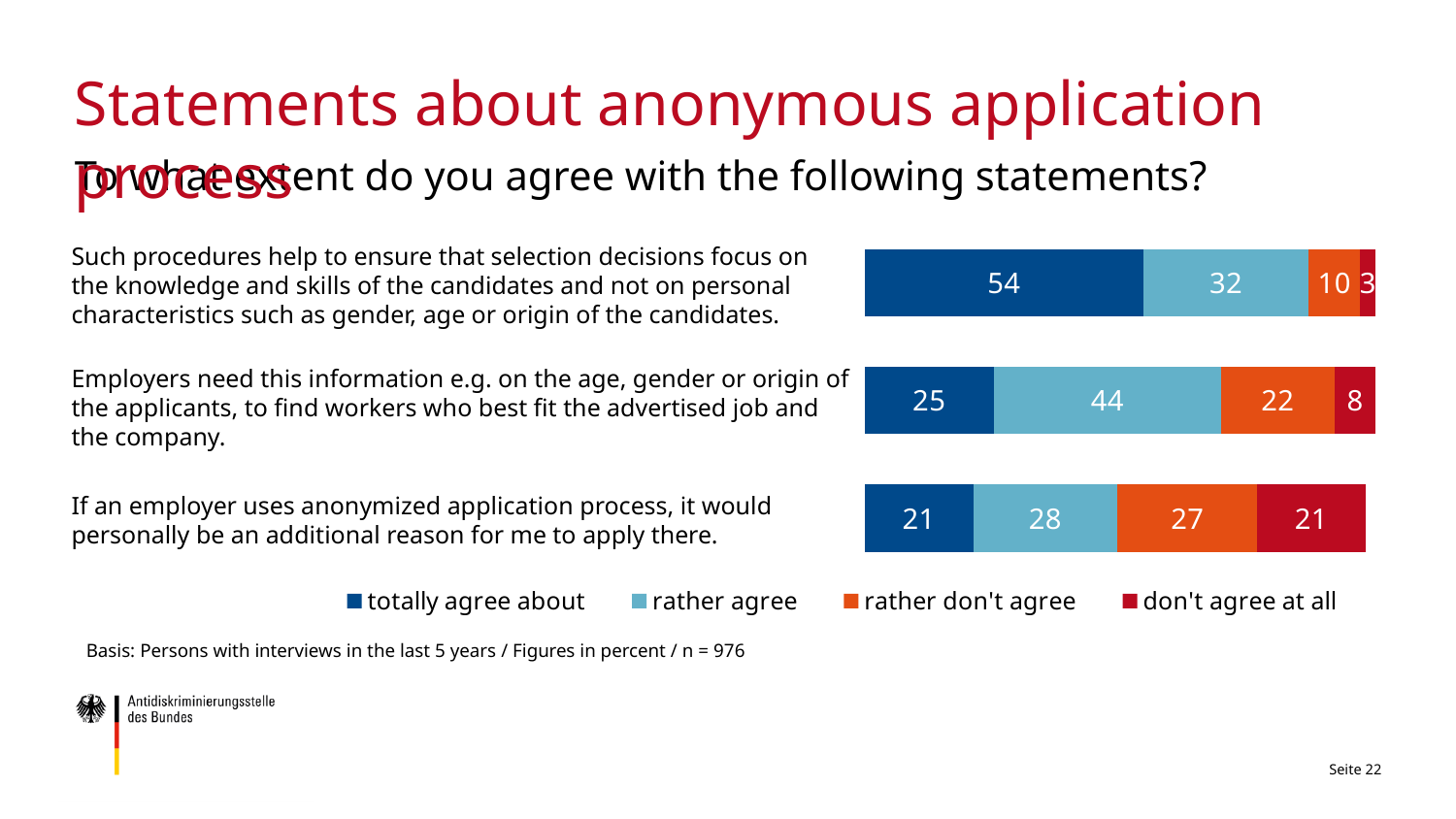
What is the difference between the 'totally agree' share for the statement that such procedures help focus on knowledge and skills and the 'totally agree' share for the statement that employers need this information? 29 What kind of chart is shown on the slide? Stacked bar chart How many series does the legend list? 4 What percentage of respondents totally agree that such procedures help to ensure that selection decisions focus on the knowledge and skills of the candidates? 54 Which statement has the highest share of respondents who totally agree? Such procedures help to ensure that selection decisions focus on the knowledge and skills of the candidates What percentage of respondents rather don't agree that employers need this information on the age, gender or origin of the applicants? 22 What percentage of respondents rather agree that employers need this information on the age, gender or origin of the applicants? 44 For the statement that an anonymized application process would be an additional reason to apply, which is larger: the 'rather agree' share or the 'rather don't agree' share? rather agree How many statements are shown in the chart? 3 Which statement has the lowest share of respondents who don't agree at all? Such procedures help to ensure that selection decisions focus on the knowledge and skills of the candidates What is the combined share of 'totally agree' and 'rather agree' for the statement that employers need this information on the age, gender or origin of the applicants? 69 What percentage of respondents don't agree at all that an anonymized application process would personally be an additional reason to apply there? 21